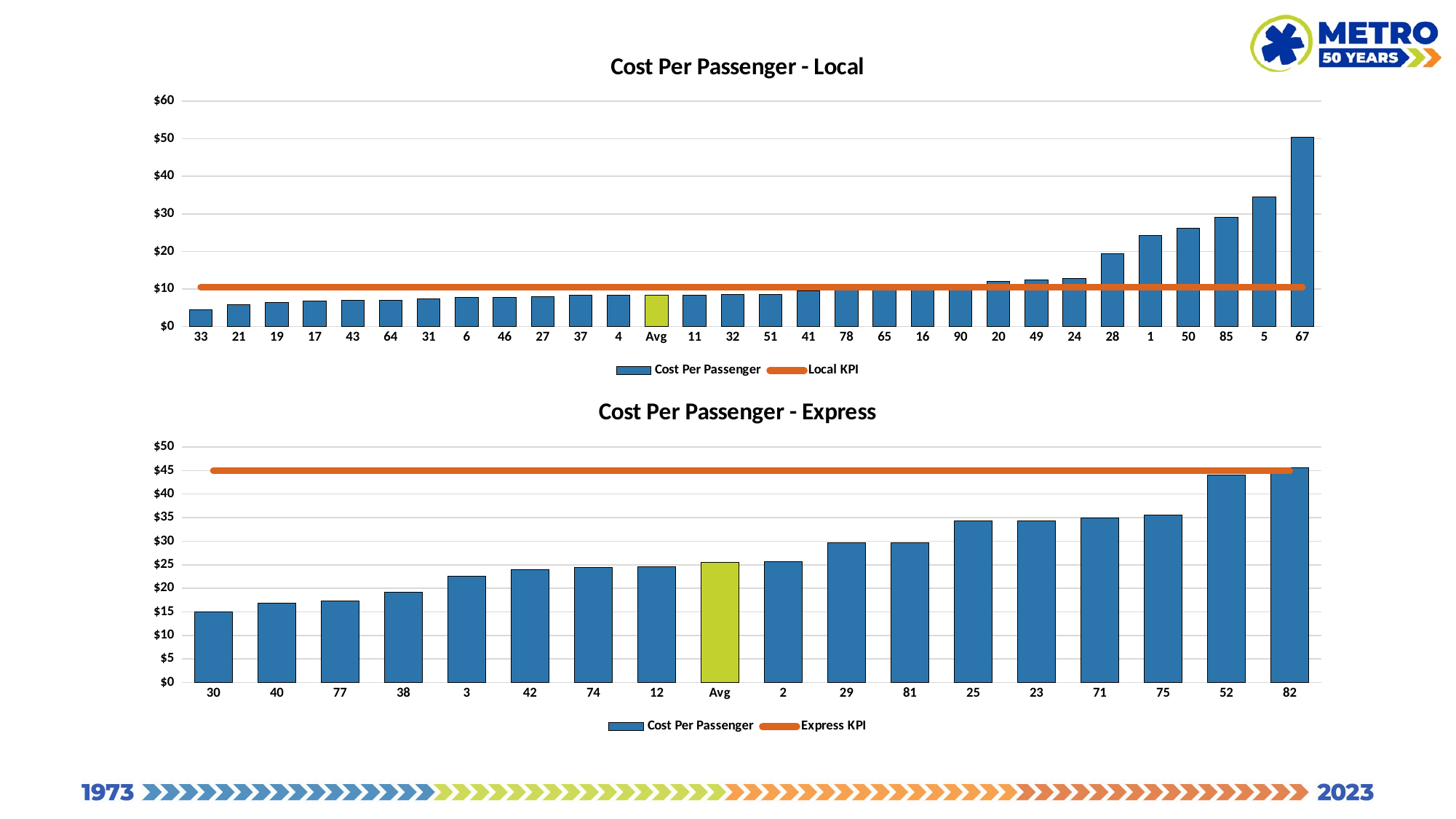
In the 'Cost Per Passenger - Express' chart, how many bars are plotted, including the Avg bar? 18 In the 'Cost Per Passenger - Local' chart, is the value for route 33 greater or less than $10? less In the 'Cost Per Passenger - Local' chart, which route has the lowest cost per passenger? 33 In the 'Cost Per Passenger - Express' chart, which route has the highest cost per passenger? 82 In the 'Cost Per Passenger - Express' chart, which route has the lowest cost per passenger? 30 In the 'Cost Per Passenger - Local' chart, is the value for route 67 greater or less than $40? greater In the 'Cost Per Passenger - Local' chart, how many entries does the legend list? 2 What kind of chart is 'Cost Per Passenger - Express'? Combination bar and line chart In the 'Cost Per Passenger - Express' chart, is the value for route 30 greater or less than $20? less In the 'Cost Per Passenger - Local' chart, do the bar values rise or fall from left to right? Rise In the 'Cost Per Passenger - Local' chart, which route has the highest cost per passenger? 67